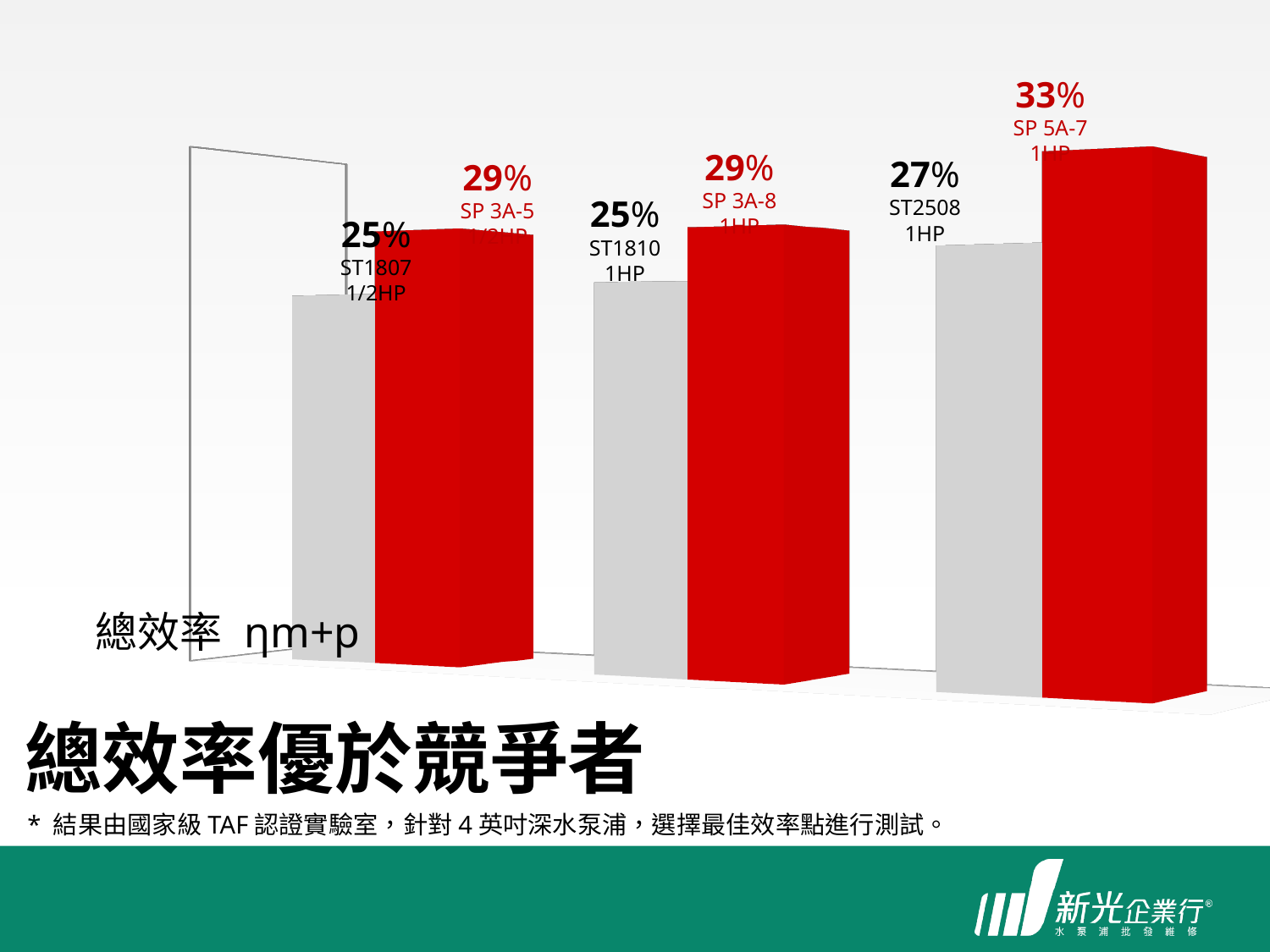
What is the total efficiency value shown for SP 3A-5? 29% Which pump model has the highest total efficiency on the chart? SP 5A-7 What is the total efficiency value shown for ST2508? 27% What is the total efficiency value shown for ST1810? 25% What is the total efficiency value shown for SP 5A-7? 33% Which has a higher total efficiency, SP 3A-8 or ST1810? SP 3A-8 How many bars are plotted on the chart? 6 What type of chart is shown on the slide? Bar chart What is the total efficiency value shown for SP 3A-8? 29% What is the difference in total efficiency between SP 3A-5 and ST1807? 4% What is the total efficiency value shown for ST1807? 25% What is the difference in total efficiency between SP 5A-7 and ST2508? 6%